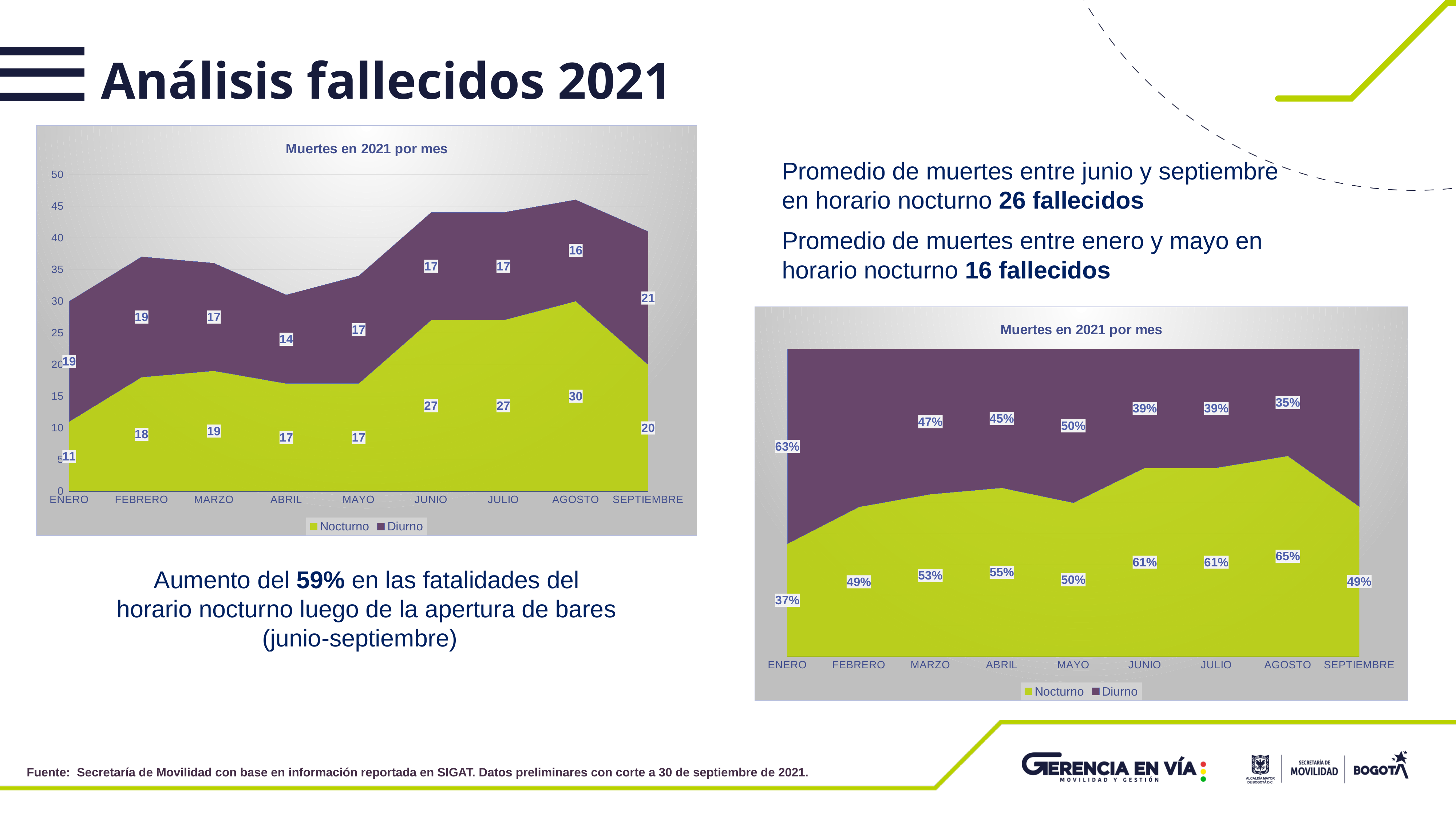
In the chart on the left, is the Nocturno value for JUNIO larger than the Diurno value for JUNIO? Yes (27 vs 17) How many series does the legend of the chart on the right list? 2 What type of chart is the chart on the left of the slide? Stacked area chart In the chart on the left, which month has the lowest Nocturno value? ENERO In the chart on the left, what is the difference between the Nocturno values for AGOSTO and ENERO? 19 How many months are shown on the x axis of the chart on the left? 9 In the chart on the right, what is the Nocturno share for AGOSTO? 65% In the chart on the left, what is the Nocturno value for AGOSTO? 30 In the chart on the left, what is the total of Nocturno and Diurno for SEPTIEMBRE? 41 In the chart on the right, what is the Nocturno share for ENERO? 37% In the chart on the left, which month has the highest Nocturno value? AGOSTO In the chart on the left, what is the Diurno value for ABRIL? 14